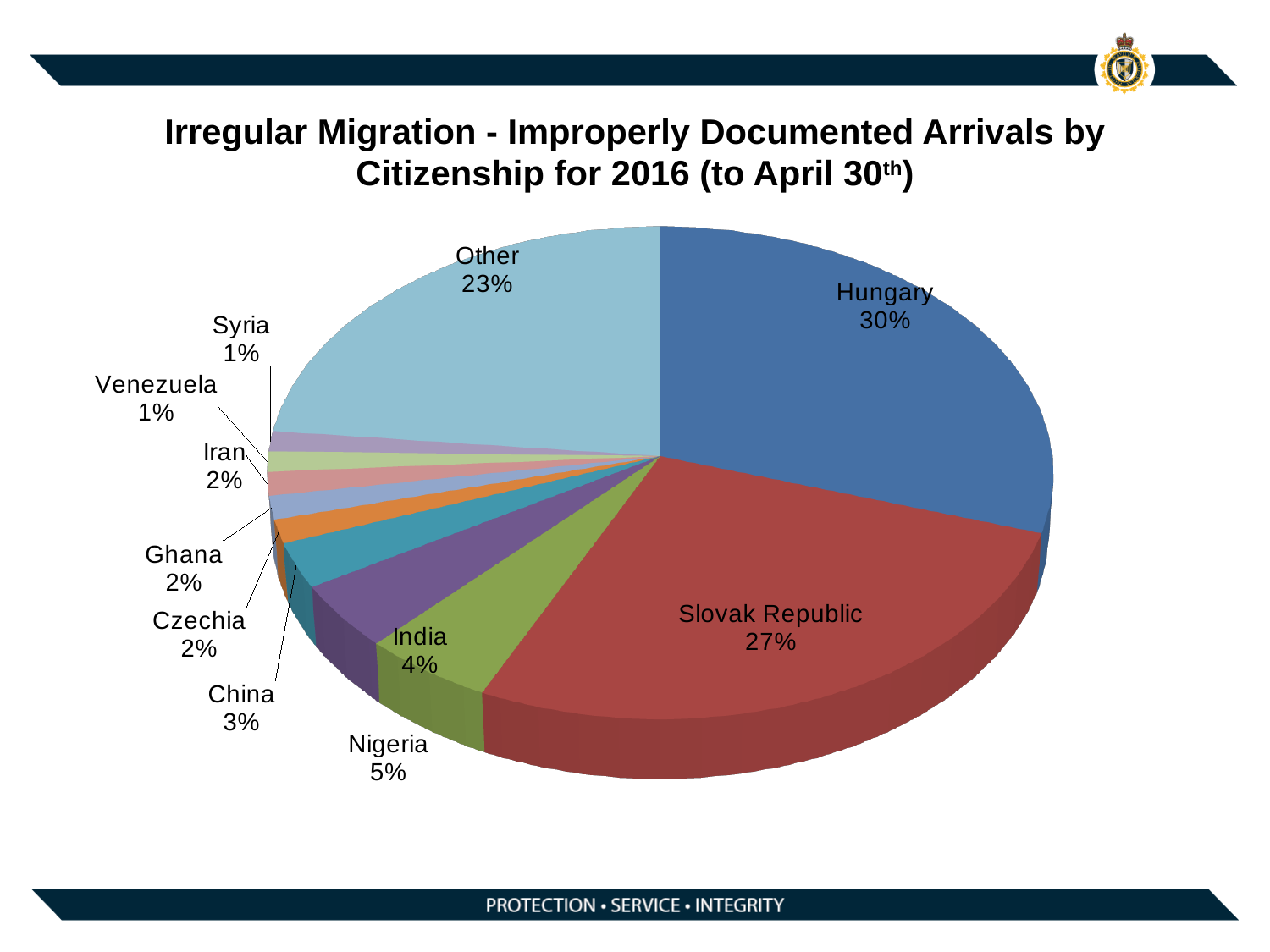
What share is labelled for the 'Other' category? 23% What is the difference in percentage points between Hungary and the Slovak Republic? 3 What type of chart is shown on the slide? Pie chart What is the title of the chart? Irregular Migration - Improperly Documented Arrivals by Citizenship for 2016 (to April 30th) What percentage of the pie is the Slovak Republic? 27% What share does Nigeria hold in the chart? 5% What percentage is shown for China? 3% Which is larger, the share for India or the share for Nigeria? Nigeria How many slices does the pie chart have? 11 Which named citizenship has the largest share of the pie? Hungary What share of improperly documented arrivals is attributed to Hungary? 30% Which citizenships share the smallest slice at 1%? Venezuela and Syria